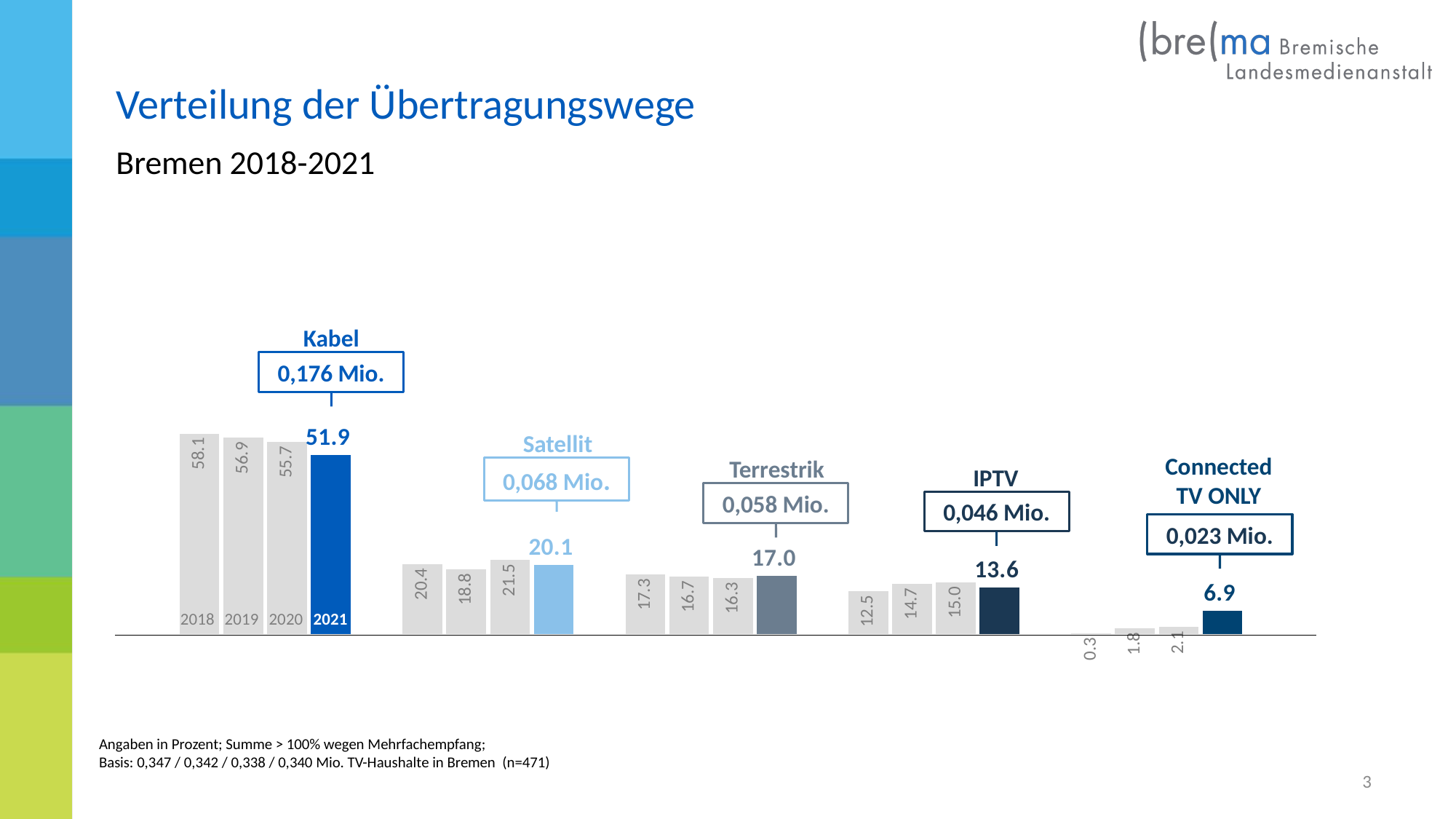
What is the difference between the Kabel values for 2018 and 2021? 6.2 Which transmission path has the highest value in 2021? Kabel Which transmission path has the lowest value in 2021? Connected TV ONLY Which is larger, the IPTV value in 2021 or the Terrestrik value in 2021? Terrestrik What number of households in millions is shown in the box above the Satellit bars? 0,068 Mio. What is the value for Connected TV ONLY in 2018? 0.3 Do the IPTV values rise or fall from 2018 to 2021? rise How many transmission path groups are shown in the chart? 5 What is the value for Satellit in 2019? 18.8 Do the Kabel values rise or fall from 2018 to 2021? fall What kind of chart is shown on the slide? bar chart What is the value for Kabel in 2021? 51.9